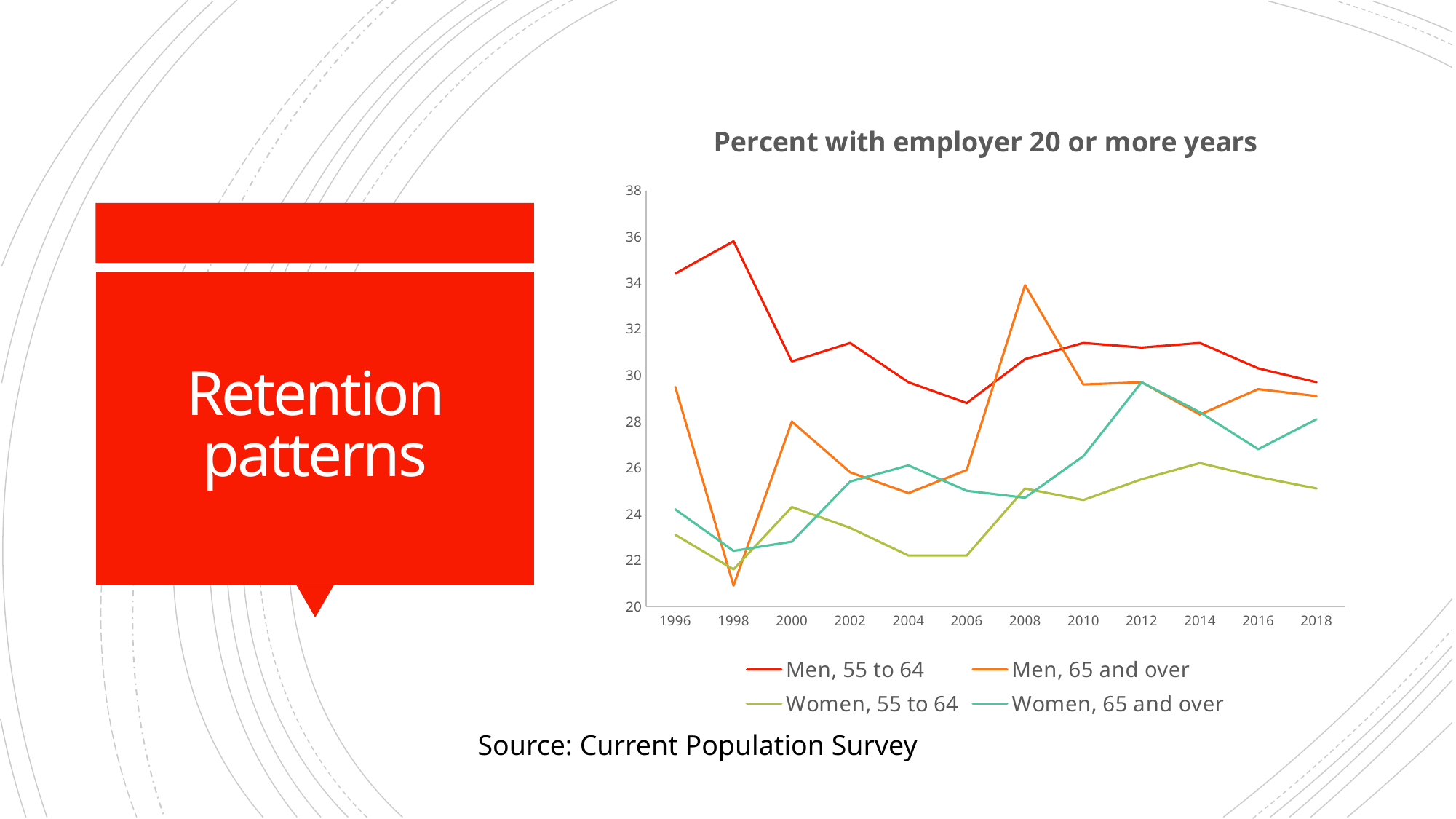
Is the value for Men, 65 and over in 1998 greater or less than 22? less What kind of chart is shown on the slide? line chart What is the title of the chart? Percent with employer 20 or more years What source is cited for the chart? Current Population Survey Is the value for Men, 65 and over in 2008 greater or less than 32? greater Is the value for Men, 55 to 64 in 1998 greater or less than 34? greater How many years are shown along the x axis? 12 Which series has the highest value in 1996? Men, 55 to 64 How many series does the legend list? 4 In 2008, which is larger: Men, 65 and over or Men, 55 to 64? Men, 65 and over Which series has the lowest value in 2018? Women, 55 to 64